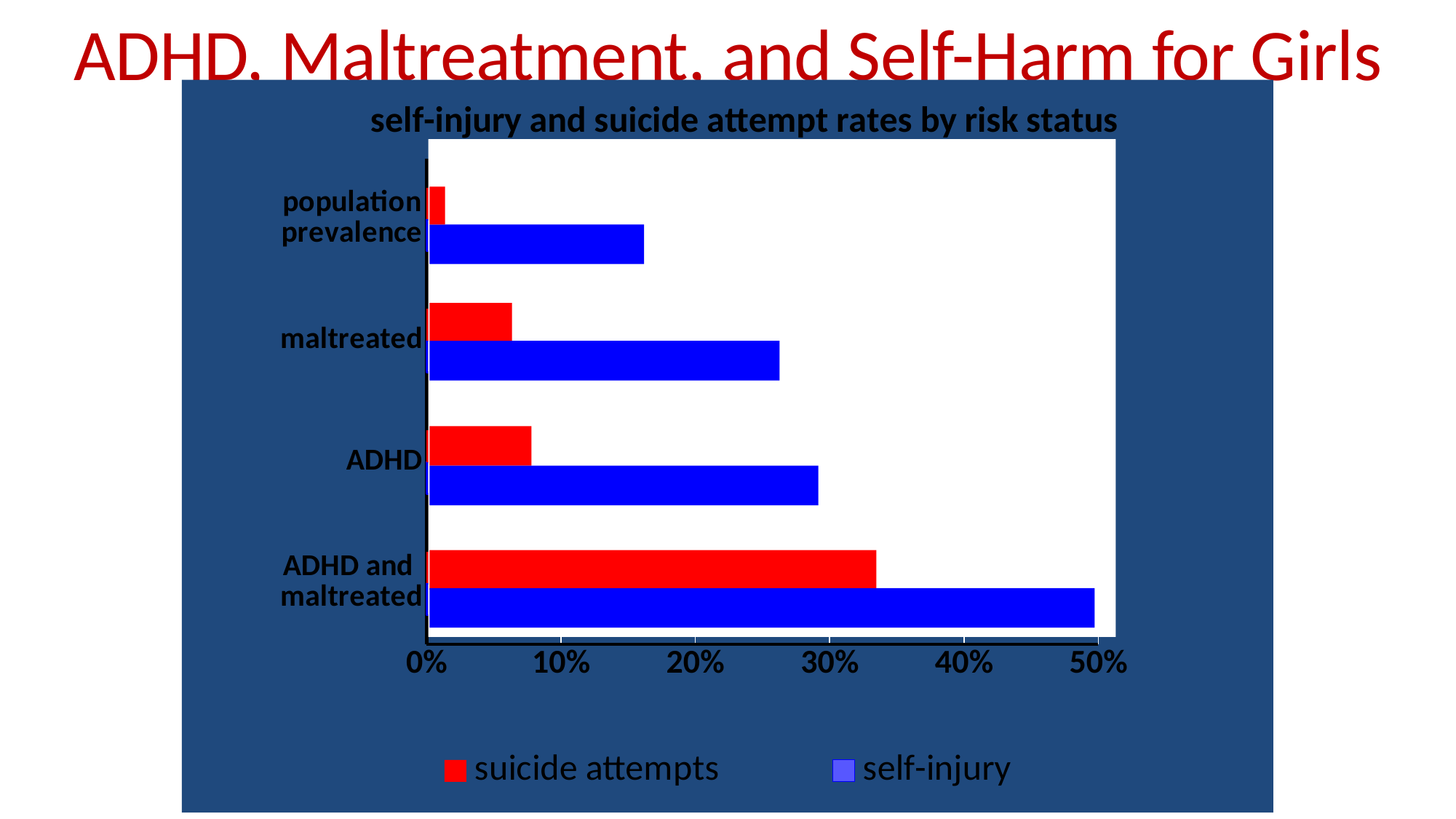
What is the title of the chart? self-injury and suicide attempt rates by risk status Is the suicide attempts rate for ADHD greater or less than 10%? less Is the self-injury rate for maltreated greater or less than 20%? greater Is the self-injury rate for ADHD and maltreated greater or less than 40%? greater How many series does the legend list? 2 Which is larger: the suicide attempts rate for ADHD and maltreated or the self-injury rate for ADHD? suicide attempts rate for ADHD and maltreated What kind of chart is shown on the slide? bar chart Which category has the lowest suicide attempts rate? population prevalence Which category has the highest self-injury rate? ADHD and maltreated Which category has the lowest self-injury rate? population prevalence How many risk status categories are shown on the chart? 4 Which colour represents suicide attempts in the legend? red